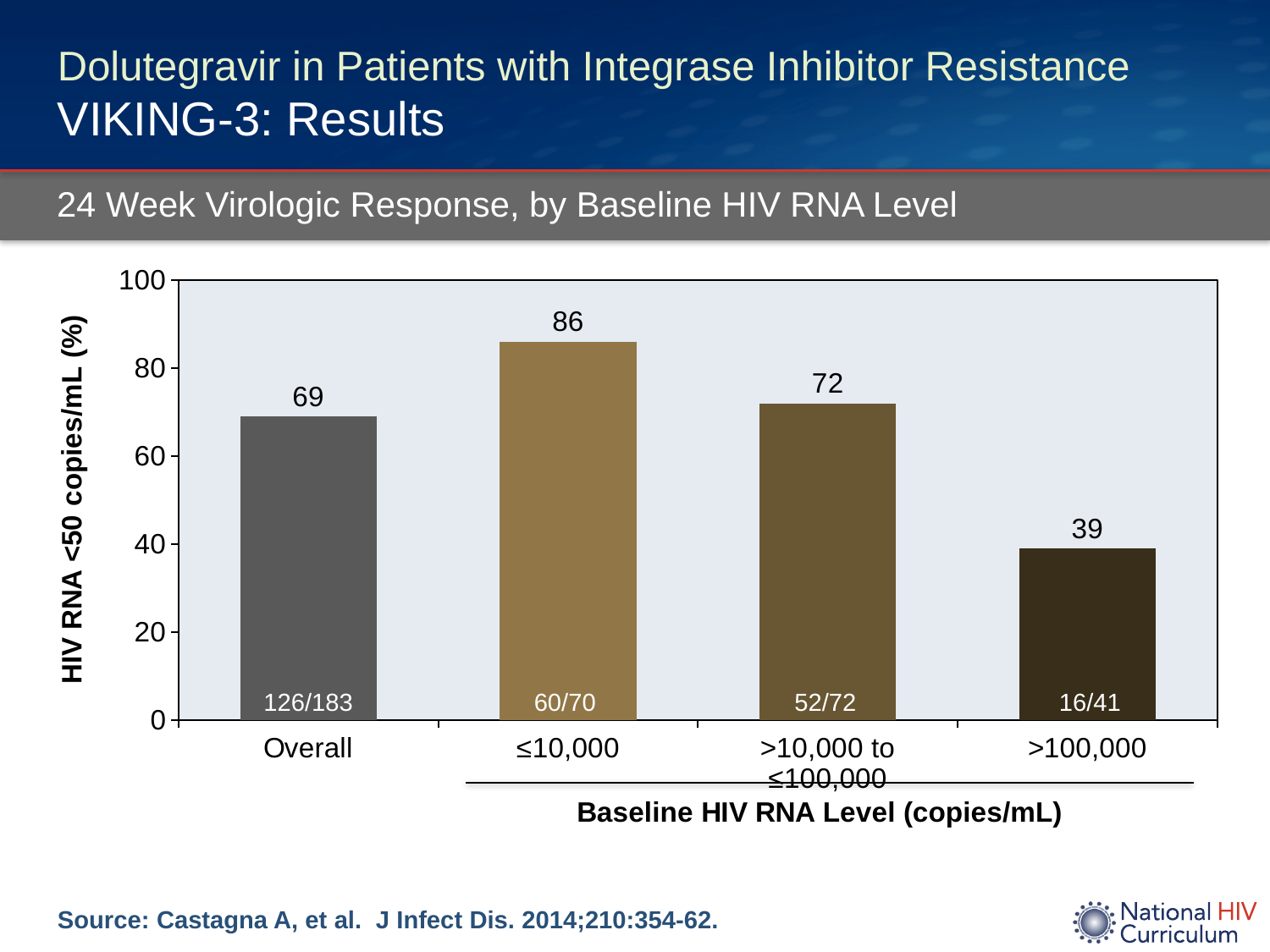
What is the label of the y-axis? HIV RNA <50 copies/mL (%) Which has a higher response percentage, the Overall group or the >10,000 to ≤100,000 group? >10,000 to ≤100,000 Which category has the lowest virologic response percentage? >100,000 What is the percentage of patients with HIV RNA <50 copies/mL in the Overall group? 69 How many bars are shown in the chart? 4 What is the percentage of patients with HIV RNA <50 copies/mL in the >100,000 baseline HIV RNA group? 39 What type of chart is shown on the slide? Bar chart What fraction of patients is shown inside the bar for the >10,000 to ≤100,000 group? 52/72 What is the difference in response percentage between the ≤10,000 group and the >100,000 group? 47 What is the percentage of patients with HIV RNA <50 copies/mL in the ≤10,000 baseline HIV RNA group? 86 Across the three baseline HIV RNA level categories from ≤10,000 to >100,000, does the response percentage rise or fall? Fall Which baseline HIV RNA category has the highest virologic response percentage? ≤10,000